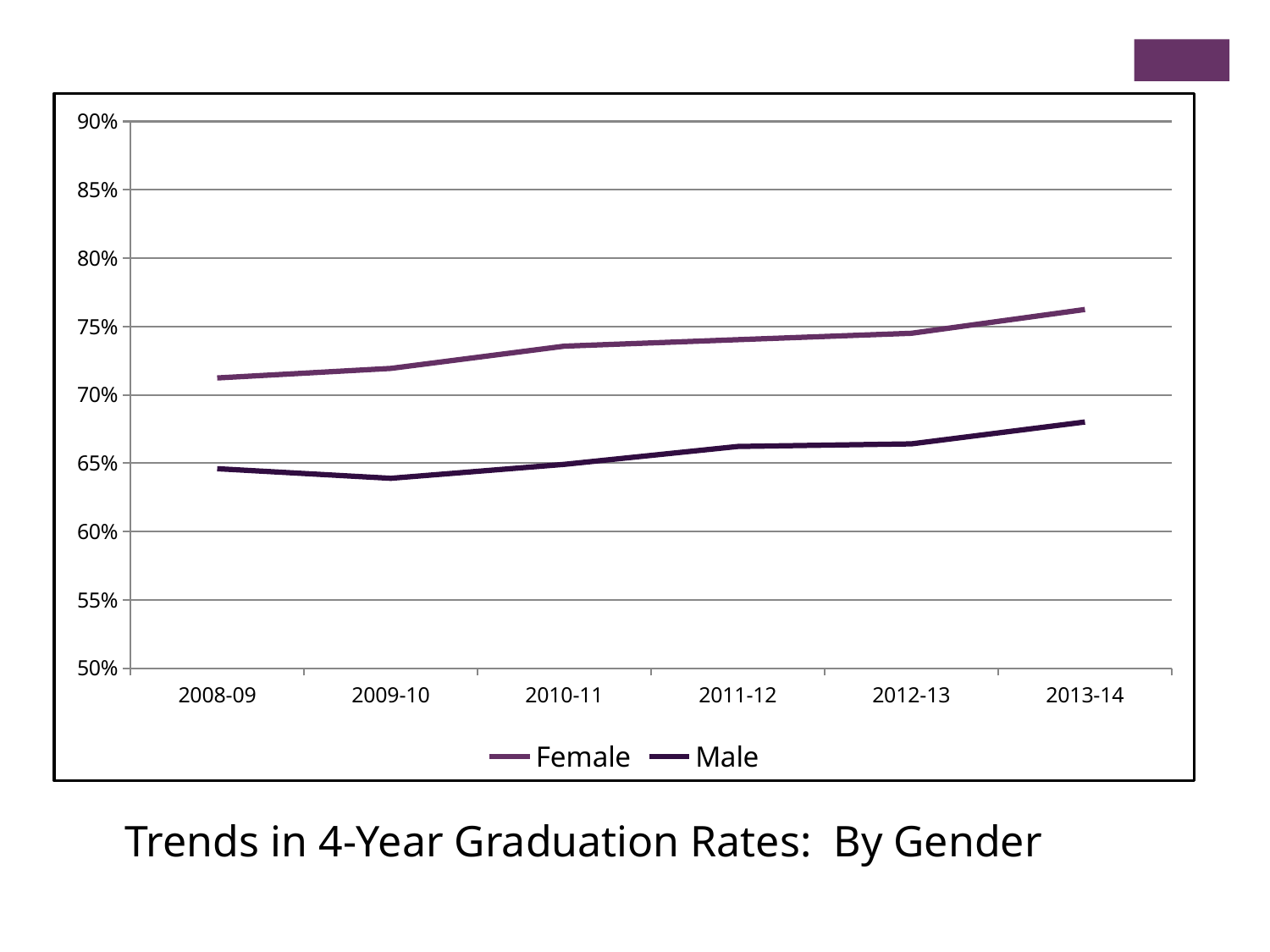
What is the title shown below the chart? Trends in 4-Year Graduation Rates: By Gender In which year is the Female graduation rate highest? 2013-14 What kind of chart is shown on the slide? line chart Is the Male value for 2013-14 greater or less than 65%? greater Is the Female value for 2010-11 greater or less than 75%? less Is the Female value for 2013-14 greater or less than 75%? greater Does the Female graduation rate rise or fall from 2008-09 to 2013-14? rise Which series is higher in 2013-14, Female or Male? Female How many series does the legend list? 2 In which year is the Male graduation rate lowest? 2009-10 How many academic years are plotted along the x axis? 6